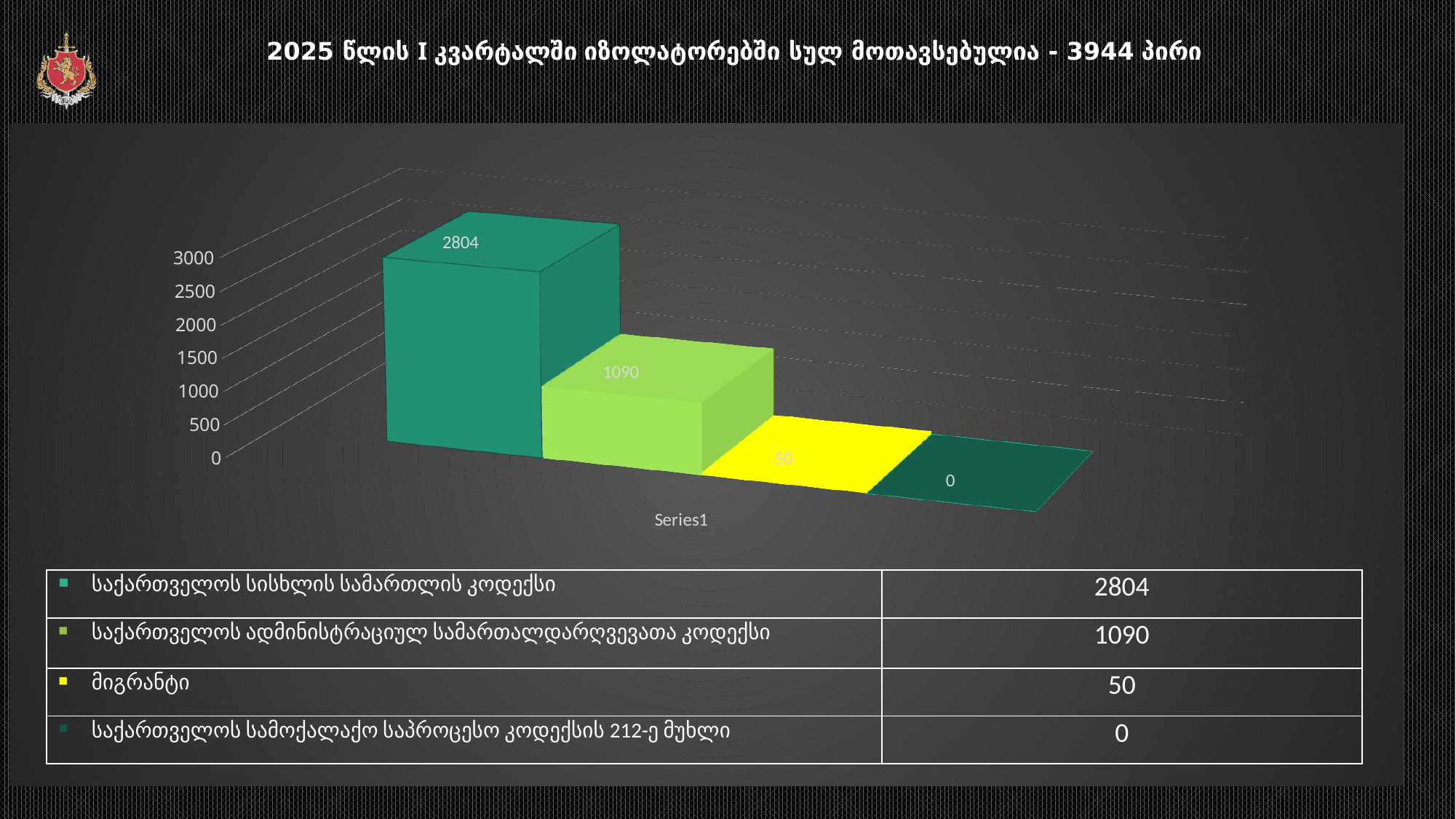
How many bars are plotted in the chart? 4 What value is shown for the light green bar labelled საქართველოს ადმინისტრაციულ სამართალდარღვევათა კოდექსი? 1090 Which is larger, the value for მიგრანტი or the value for საქართველოს ადმინისტრაციულ სამართალდარღვევათა კოდექსი? საქართველოს ადმინისტრაციულ სამართალდარღვევათა კოდექსი Which category has the highest value in the chart? საქართველოს სისხლის სამართლის კოდექსი What is the difference between the values for საქართველოს სისხლის სამართლის კოდექსი and საქართველოს ადმინისტრაციულ სამართალდარღვევათა კოდექსი? 1714 Is the value for საქართველოს სისხლის სამართლის კოდექსი greater or less than 2500? greater What kind of chart is shown on the slide? bar chart What value is shown for the yellow bar labelled მიგრანტი? 50 What value is shown for the teal bar labelled საქართველოს სისხლის სამართლის კოდექსი? 2804 Which category has the lowest value in the chart? საქართველოს სამოქალაქო საპროცესო კოდექსის 212-ე მუხლი What value is shown for the dark green bar labelled საქართველოს სამოქალაქო საპროცესო კოდექსის 212-ე მუხლი? 0 What is the total of the four values plotted in the chart? 3944